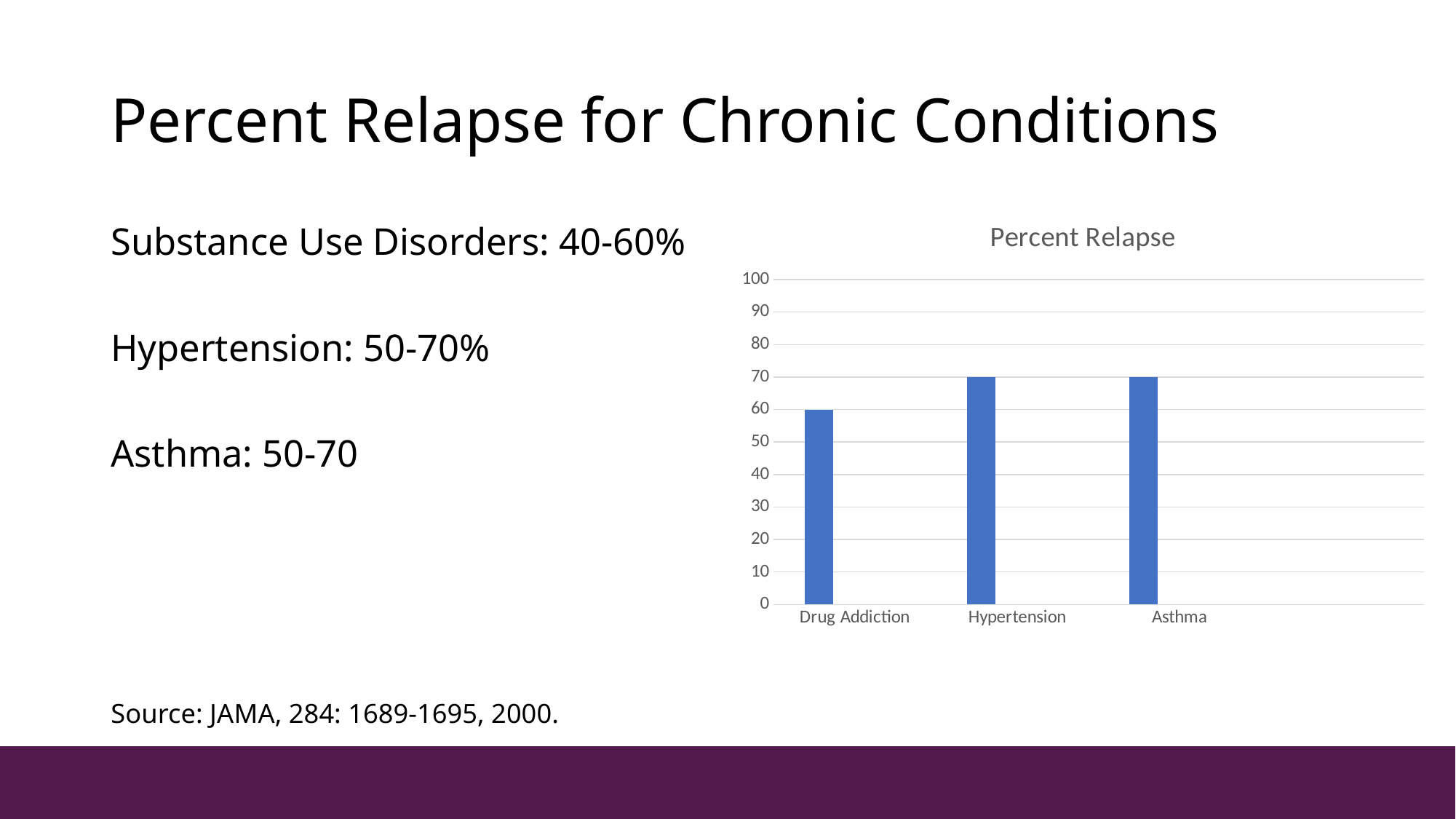
Which is larger in the Percent Relapse chart, the value for Hypertension or the value for Drug Addiction? Hypertension What is the value for Asthma in the Percent Relapse chart? 70 What is the value for Drug Addiction in the Percent Relapse chart? 60 How many categories are shown in the Percent Relapse chart? 3 What is the value for Hypertension in the Percent Relapse chart? 70 Is the value for Drug Addiction greater or less than 50 in the Percent Relapse chart? greater Which category has the lowest value in the Percent Relapse chart? Drug Addiction What is the title of the chart on the slide? Percent Relapse What is the difference between the values for Hypertension and Drug Addiction in the Percent Relapse chart? 10 What is the highest value shown on the vertical axis of the Percent Relapse chart? 100 What kind of chart is the Percent Relapse chart? bar chart Is the value for Asthma greater or less than 80 in the Percent Relapse chart? less